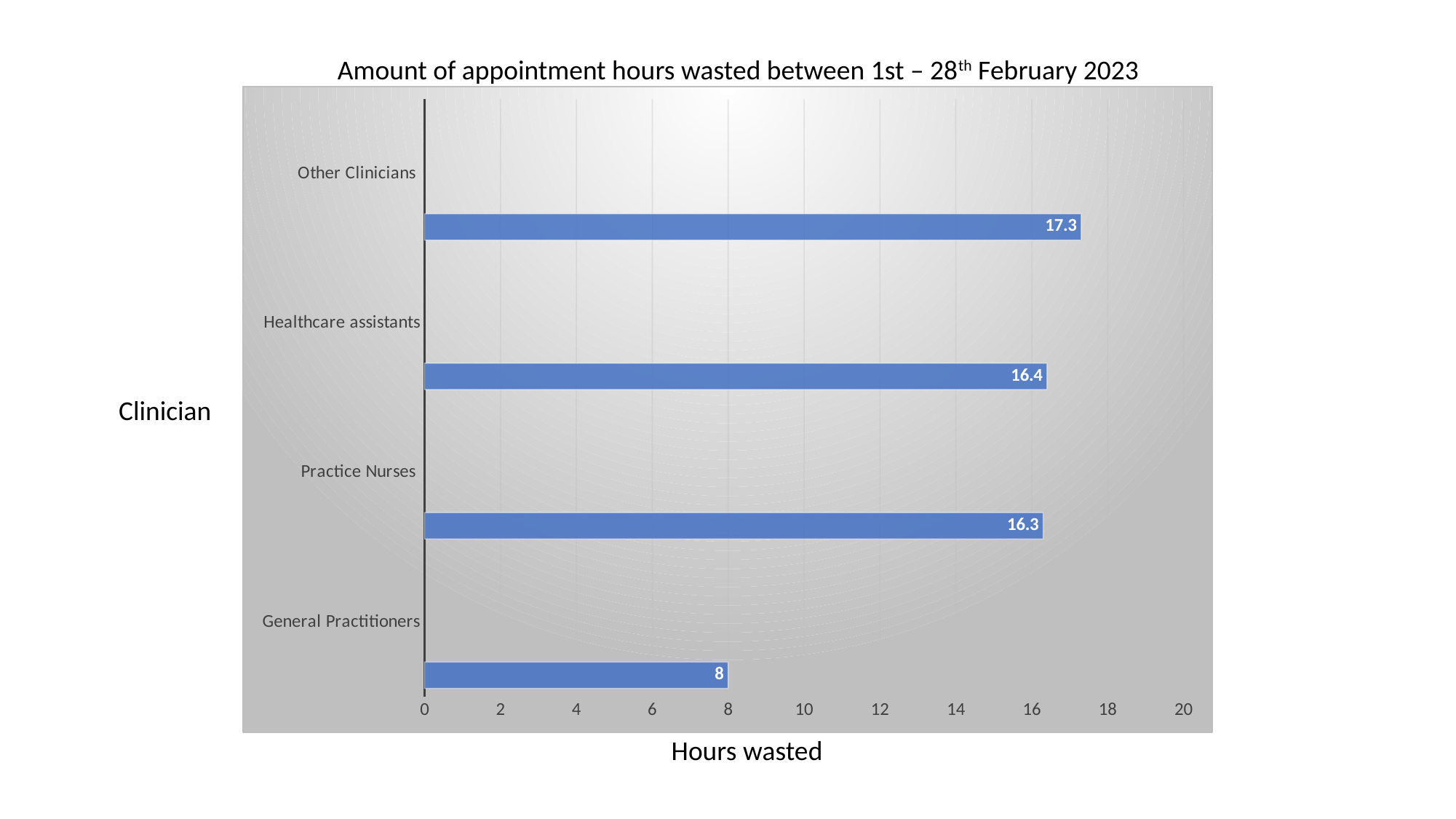
What kind of chart is shown on the slide? Bar chart What is the difference in hours wasted between Other Clinicians and General Practitioners? 9.3 What is the value for Healthcare assistants? 16.4 How many hours were wasted by General Practitioners? 8 What is the value for Other Clinicians? 17.3 Is the value for General Practitioners greater or less than 10? less What is the label of the horizontal axis? Hours wasted What is the value for Practice Nurses? 16.3 Which has more hours wasted, Other Clinicians or General Practitioners? Other Clinicians Which clinician group has the lowest number of hours wasted? General Practitioners Which clinician group has the highest number of hours wasted? Other Clinicians How many clinician categories are shown in the chart? 4